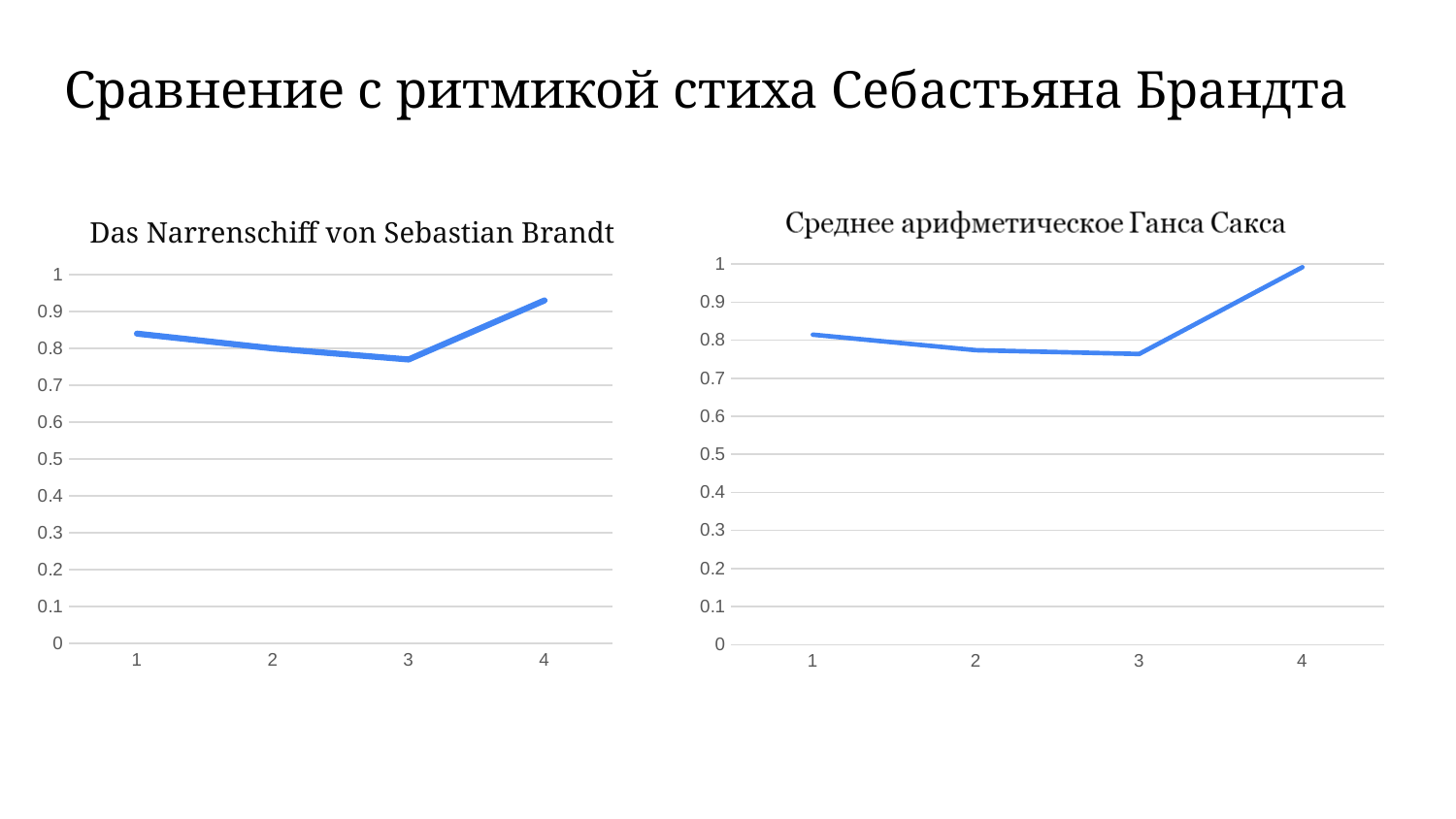
In the chart titled "Das Narrenschiff von Sebastian Brandt", which is larger, the value at position 1 or the value at position 3? position 1 In the chart titled "Среднее арифметическое Ганса Сакса", do the values rise or fall from position 1 to position 3? fall In the chart titled "Das Narrenschiff von Sebastian Brandt", which x-axis position has the lowest value? 3 How many points are plotted on the x axis of the chart titled "Среднее арифметическое Ганса Сакса"? 4 In the chart titled "Среднее арифметическое Ганса Сакса", is the value at position 3 greater or less than 0.8? less In the chart titled "Das Narrenschiff von Sebastian Brandt", is the value at position 4 greater or less than 0.9? greater What kind of chart is the chart titled "Das Narrenschiff von Sebastian Brandt"? line chart In the chart titled "Среднее арифметическое Ганса Сакса", which x-axis position has the highest value? 4 What is the title of the chart on the right side of the slide? Среднее арифметическое Ганса Сакса In the chart titled "Das Narrenschiff von Sebastian Brandt", which x-axis position has the highest value? 4 In the chart titled "Das Narrenschiff von Sebastian Brandt", is the value at position 3 greater or less than 0.8? less